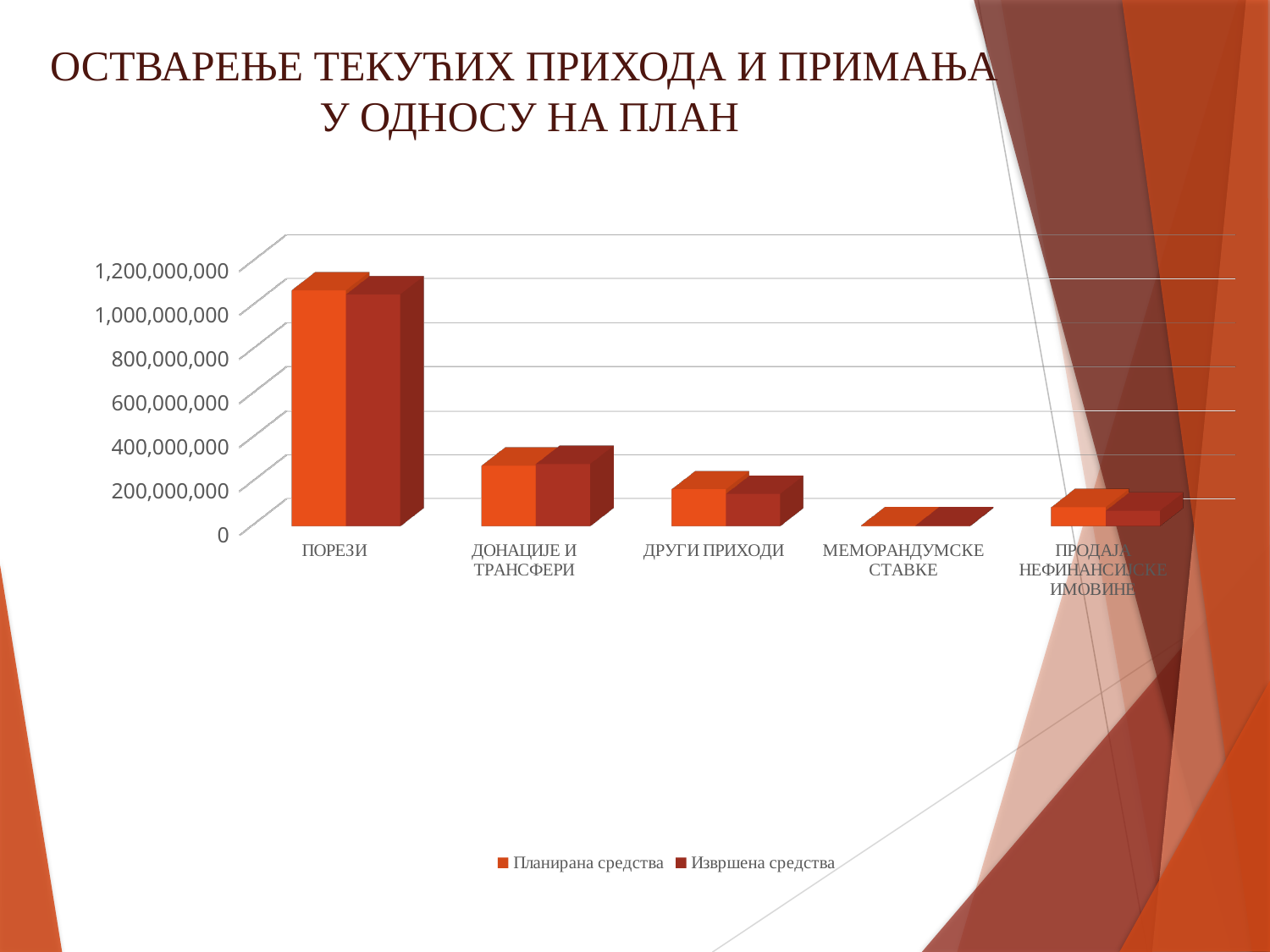
Which category has the highest value for Планирана средства? ПОРЕЗИ What are the two series named in the legend? Планирана средства and Извршена средства Is the Планирана средства value for ДОНАЦИЈЕ И ТРАНСФЕРИ greater or less than 400,000,000? less Which is larger for Планирана средства: ПОРЕЗИ or ДОНАЦИЈЕ И ТРАНСФЕРИ? ПОРЕЗИ How many series does the legend list? 2 What kind of chart is shown on the slide? bar chart Which is larger for Планирана средства: ДОНАЦИЈЕ И ТРАНСФЕРИ or ДРУГИ ПРИХОДИ? ДОНАЦИЈЕ И ТРАНСФЕРИ Is the Планирана средства value for ДРУГИ ПРИХОДИ greater or less than 400,000,000? less How many categories are shown on the x axis? 5 Which category has the lowest value for Планирана средства? МЕМОРАНДУМСКЕ СТАВКЕ Is the Планирана средства value for ПОРЕЗИ greater or less than 800,000,000? greater